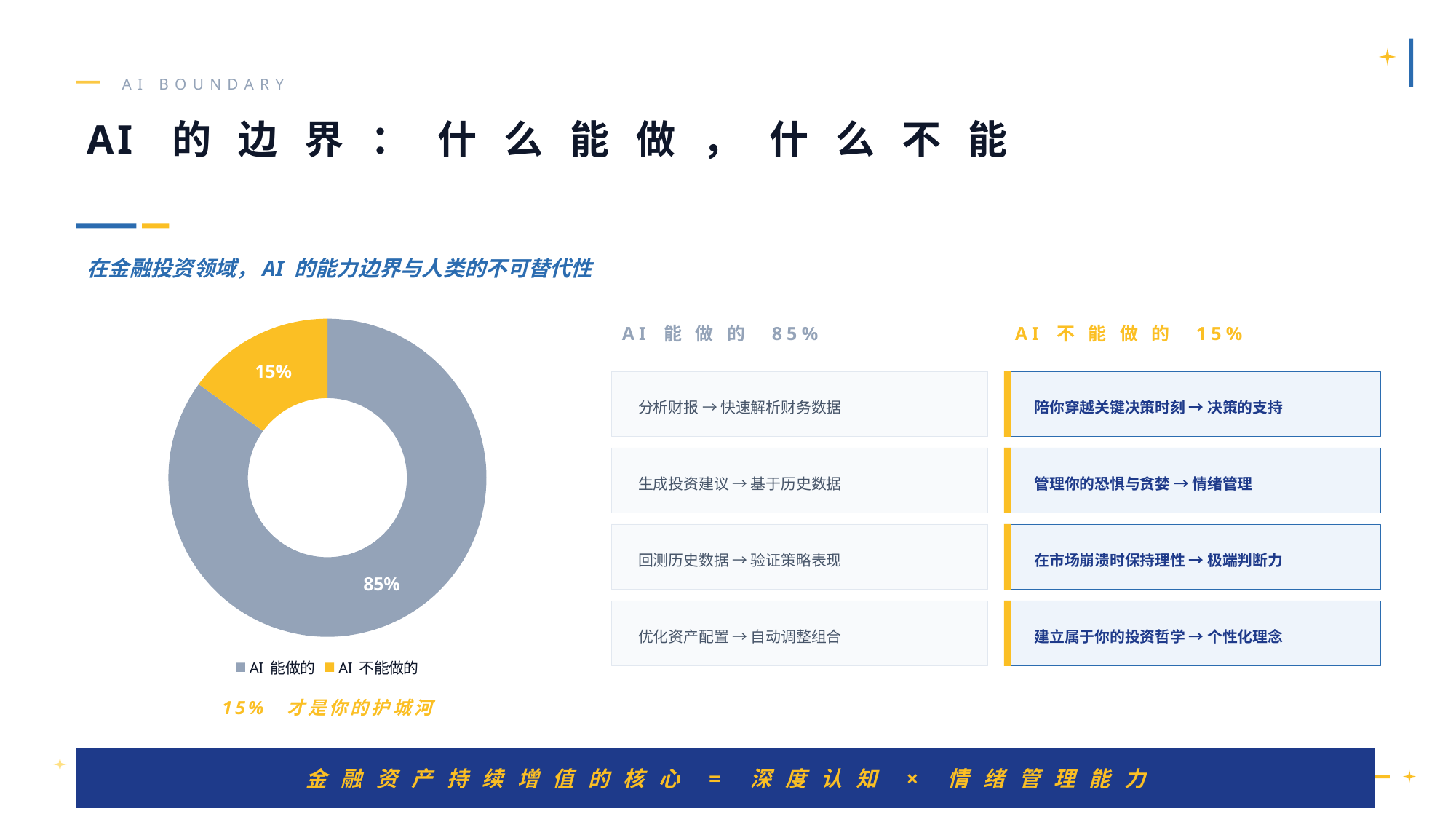
What share of the chart does the AI 不能做的 slice represent? 15% What colour is the AI 不能做的 slice in the chart? Yellow How many slices does the chart have? 2 What is the value for AI 能做的 in the chart? 85% Which is larger, the AI 能做的 slice or the AI 不能做的 slice? AI 能做的 What is the difference between the AI 能做的 and AI 不能做的 slices? 70% What kind of chart is shown on the slide? Donut (pie) chart What is the value for AI 不能做的 in the chart? 15% How many entries does the chart legend list? 2 What colour is the AI 能做的 slice in the chart? Grey Which slice of the chart is the largest? AI 能做的 Which slice of the chart is the smallest? AI 不能做的